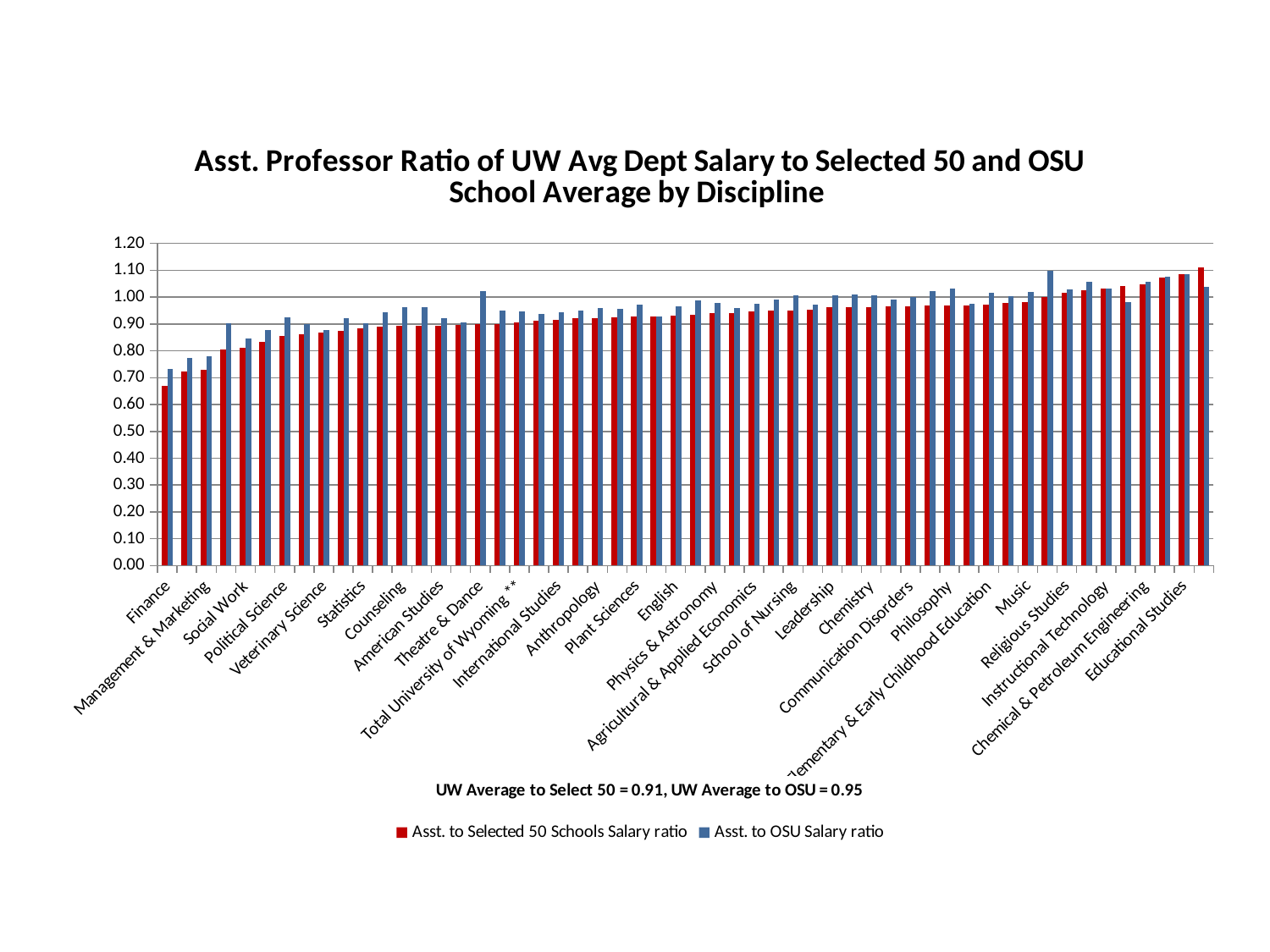
For Finance, which is larger: the Asst. to Selected 50 Schools Salary ratio or the Asst. to OSU Salary ratio? Asst. to OSU Salary ratio What kind of chart is shown on the slide? bar chart Is the Asst. to Selected 50 Schools Salary ratio for Educational Studies greater or less than 1.00? greater According to the note below the x axis, what is the UW Average to OSU ratio? 0.95 Is the Asst. to Selected 50 Schools Salary ratio for Finance greater or less than 0.70? less Is the Asst. to OSU Salary ratio for Finance greater or less than 0.70? greater Which discipline has the lowest Asst. to Selected 50 Schools Salary ratio? Finance Do the Asst. to Selected 50 Schools Salary ratio values rise or fall from left to right across the disciplines? rise For Educational Studies, which is larger: the Asst. to Selected 50 Schools Salary ratio or the Asst. to OSU Salary ratio? Neither; they are equal How many series does the legend list? 2